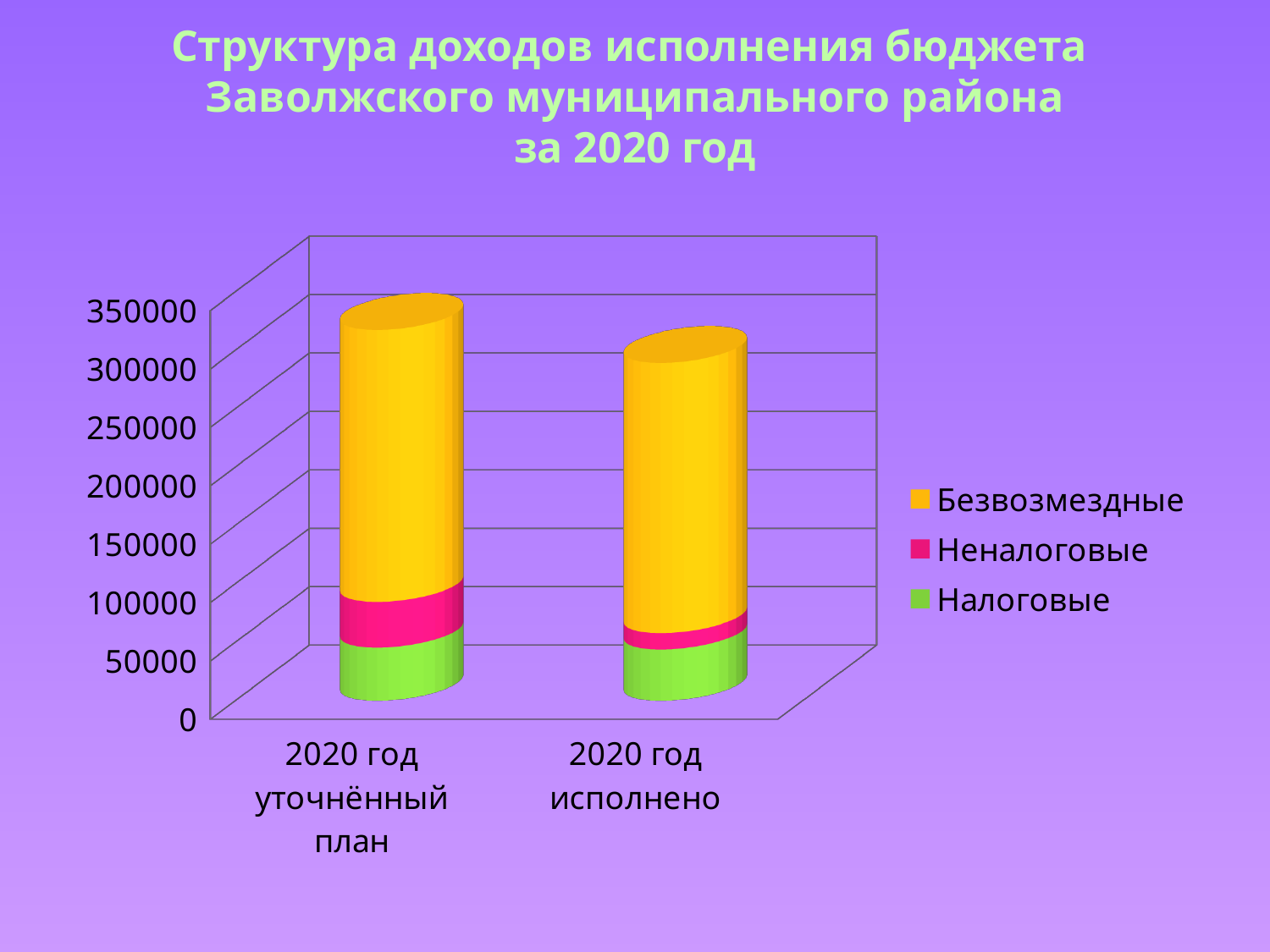
How many series does the chart legend list? 3 Is the total bar for "2020 год исполнено" greater or less than 250000? greater Is the "Налоговые" segment for "2020 год уточнённый план" greater or less than 100000? less Is the total bar for "2020 год уточнённый план" greater or less than 250000? greater Which series is shown in yellow in the chart? Безвозмездные Which series is shown in green in the chart? Налоговые Which category has the larger "Неналоговые" segment: "2020 год уточнённый план" or "2020 год исполнено"? 2020 год уточнённый план Which series forms the largest segment of the bar for "2020 год исполнено"? Безвозмездные How many categories are shown on the x axis of the chart? 2 What kind of chart is shown on the slide? Stacked bar chart Which category has the higher total bar: "2020 год уточнённый план" or "2020 год исполнено"? 2020 год уточнённый план